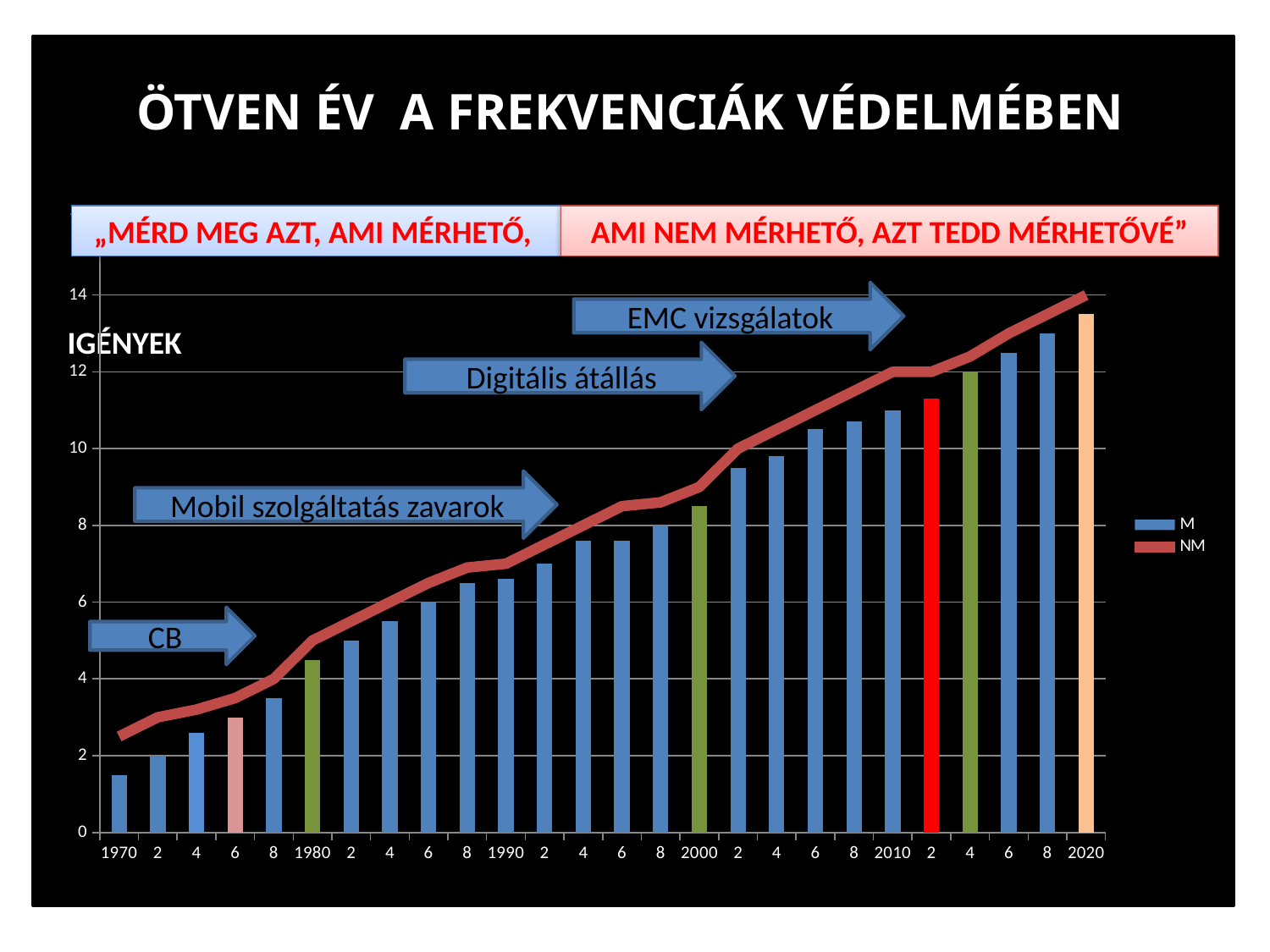
How many series does the legend list? 2 Is the bar for 2000 greater or less than 8? greater Is the bar for 2020 greater or less than 12? greater Is the bar for 1970 greater or less than 2? less Which year has the tallest bar? 2020 Do the bar values rise or fall from 1970 to 2020? rise How many bars (categories) are plotted along the x axis? 26 Which bar is taller, 2000 or 1990? 2000 Which year has the shortest bar? 1970 What kind of chart is used to plot the M series? Bar chart What are the two series named in the legend? M and NM